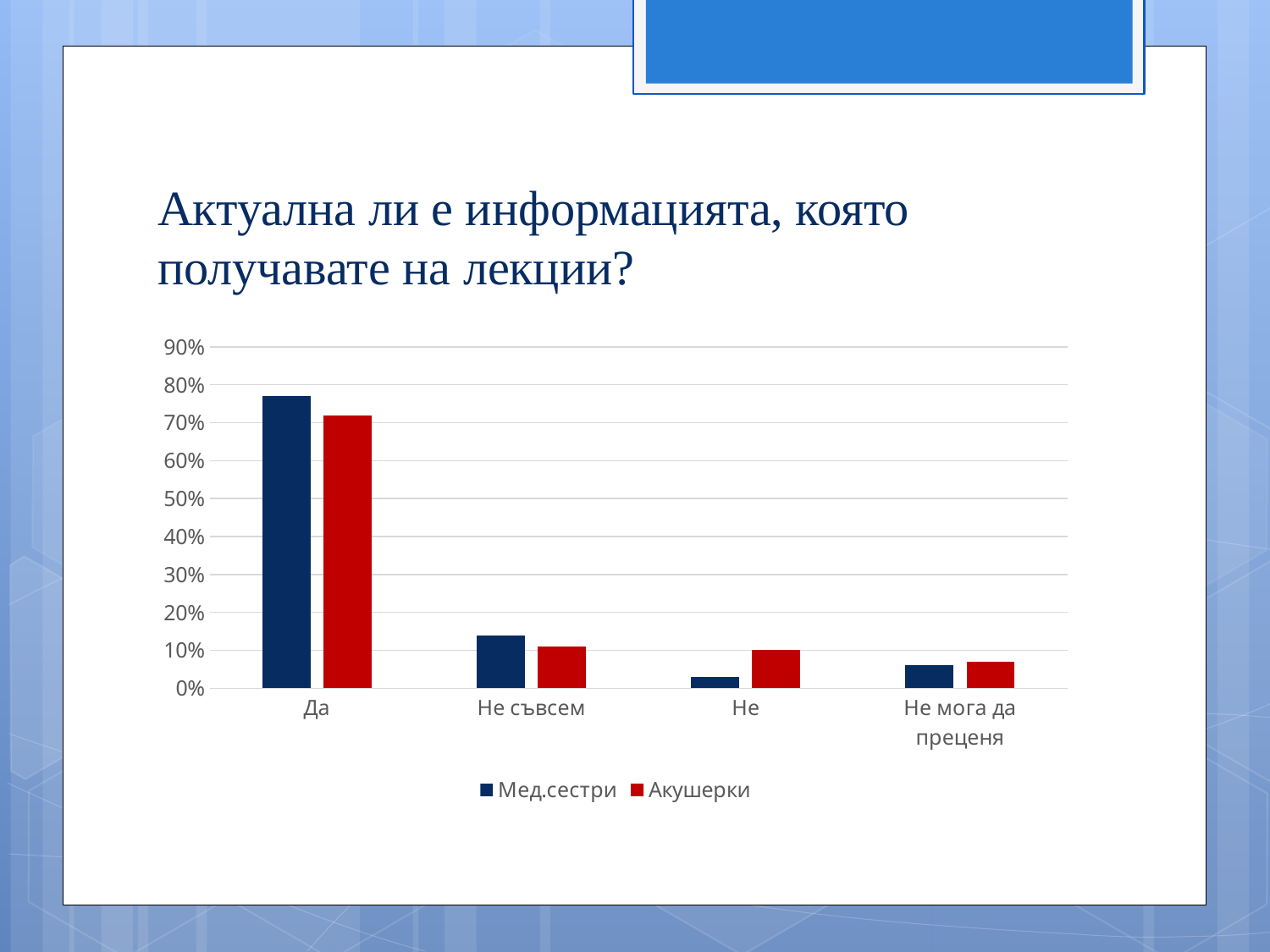
Is the value for Мед.сестри in the category Да greater or less than 70%? greater Which category has the lowest value for Мед.сестри? Не Which category has the lowest value for Акушерки? Не мога да преценя For the category Да, which series has the larger value, Мед.сестри or Акушерки? Мед.сестри Which category has the highest value for Мед.сестри? Да What is the title of the chart on the slide? Актуална ли е информацията, която получавате на лекции? For the category Не, which series has the larger value, Мед.сестри or Акушерки? Акушерки What kind of chart is shown on the slide? bar chart How many answer categories are shown on the x axis? 4 Is the value for Мед.сестри in the category Не greater or less than 10%? less How many series does the legend list? 2 Is the value for Акушерки in the category Да greater or less than 80%? less